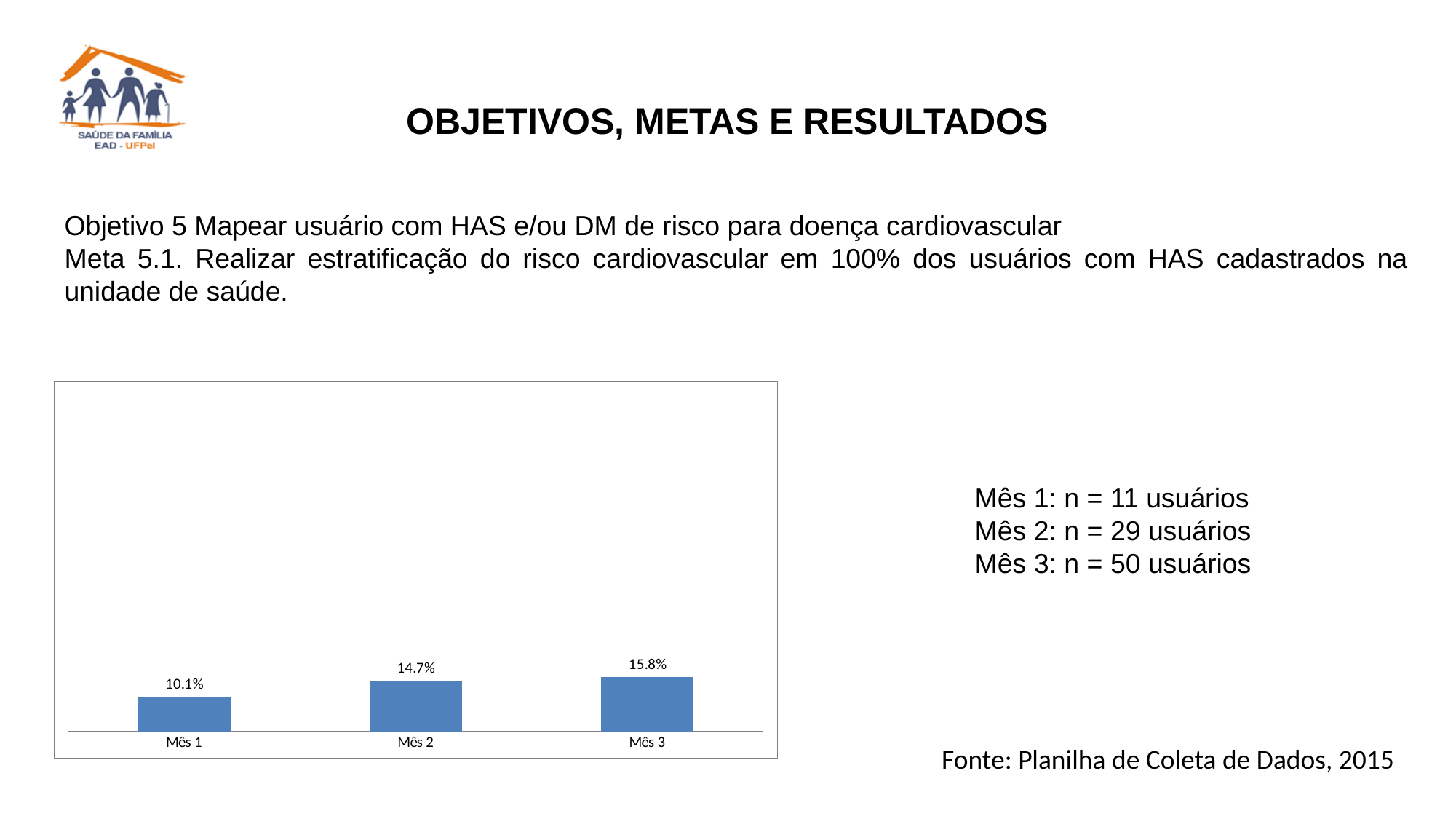
What is the difference between the values for Mês 2 and Mês 1? 4.6% What colour are the bars in the chart? Blue Which month has the highest value? Mês 3 What is the difference between the values for Mês 3 and Mês 1? 5.7% Which month has the lowest value? Mês 1 What kind of chart is shown on the slide? Bar chart What is the value for Mês 1? 10.1% What is the value for Mês 3? 15.8% What is the value for Mês 2? 14.7% Do the values rise or fall from Mês 1 to Mês 3? Rise How many categories are shown on the x axis of the chart? 3 Which is larger, the value for Mês 1 or the value for Mês 2? Mês 2